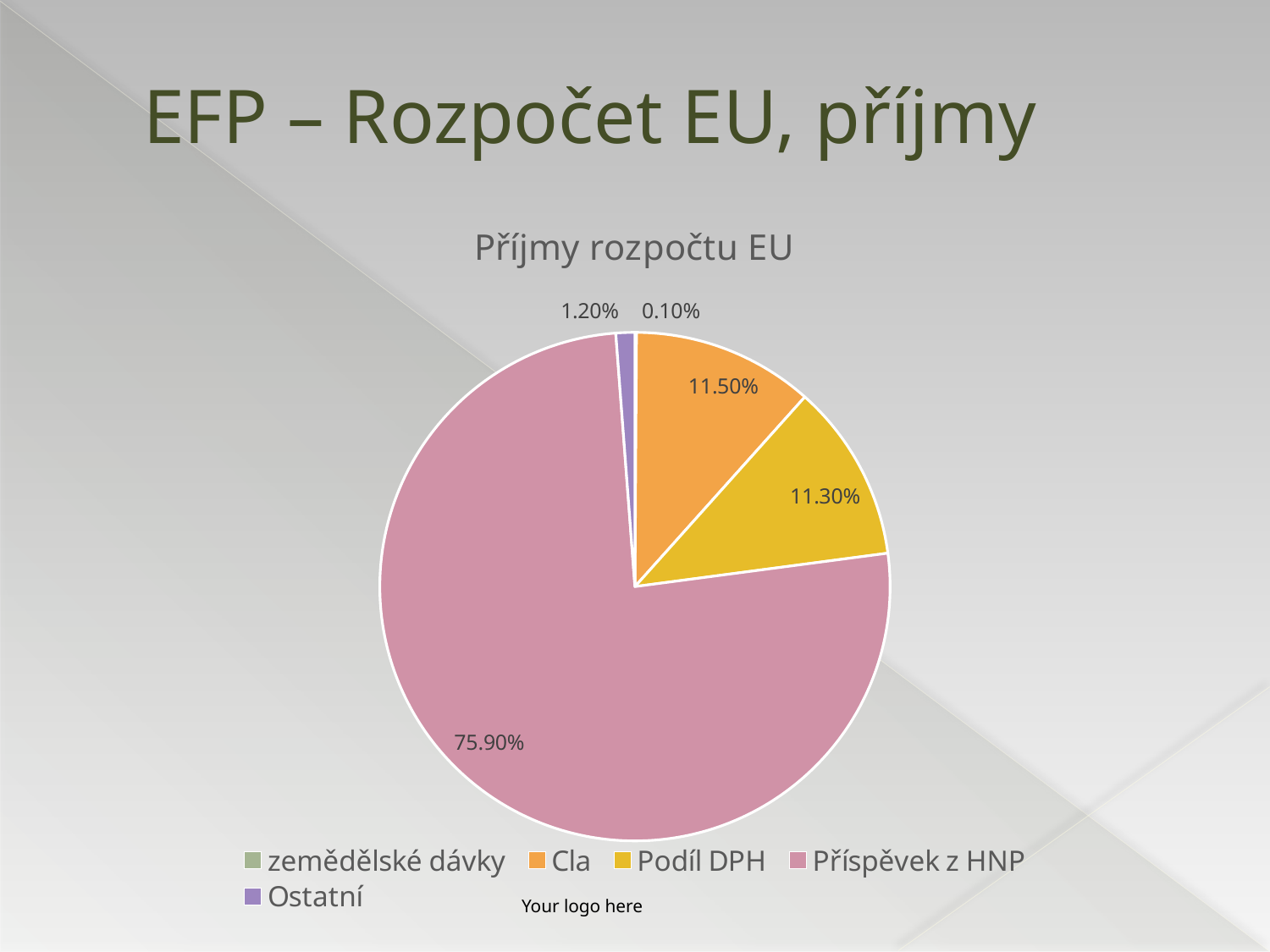
Which is larger, the slice for Ostatní or the slice for zemědělské dávky? Ostatní What type of chart is shown on the slide? pie chart What share of the pie does Ostatní represent? 1.20% What share of the pie does zemědělské dávky represent? 0.10% What is the difference in percentage points between Cla and Podíl DPH? 0.20% What share of the pie does Podíl DPH represent? 11.30% What share of the pie does Příspěvek z HNP represent? 75.90% Which category has the largest slice of the pie? Příspěvek z HNP What is the title of the chart? Příjmy rozpočtu EU Which category has the smallest slice of the pie? zemědělské dávky What share of the pie does Cla represent? 11.50% How many categories does the legend list? 5